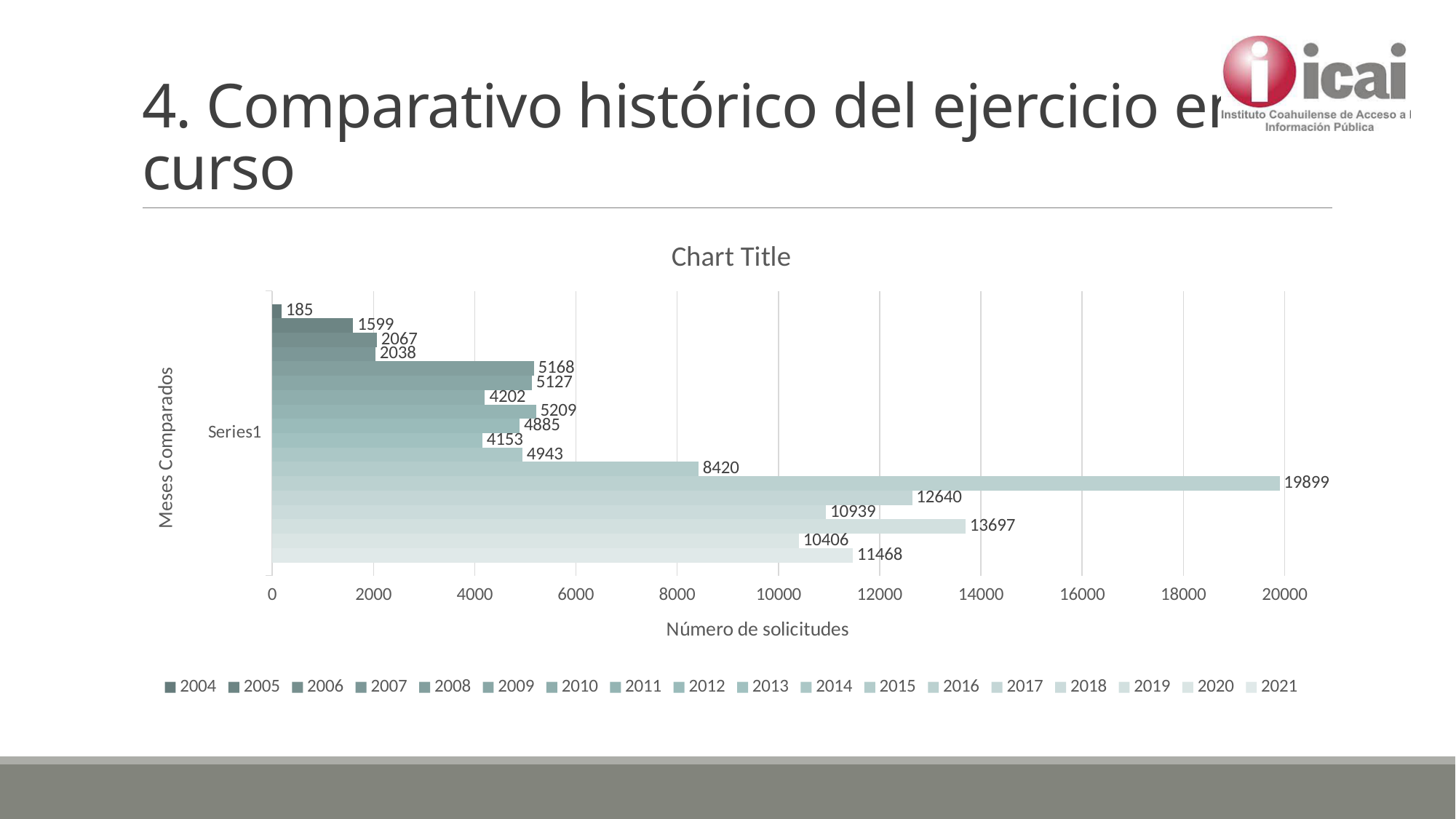
What is the value for 2004? 185 What is the difference between the values for 2016 and 2019? 6202 Which is larger, the value for 2017 or the value for 2018? 2017 What kind of chart is shown on the slide? bar chart What is the value for 2015? 8420 What is the value for 2016? 19899 How many series does the legend list? 18 What is the title shown above the chart? Chart Title Which year has the highest value? 2016 Which year has the lowest value? 2004 What is the label of the x axis? Número de solicitudes What is the value for 2021? 11468